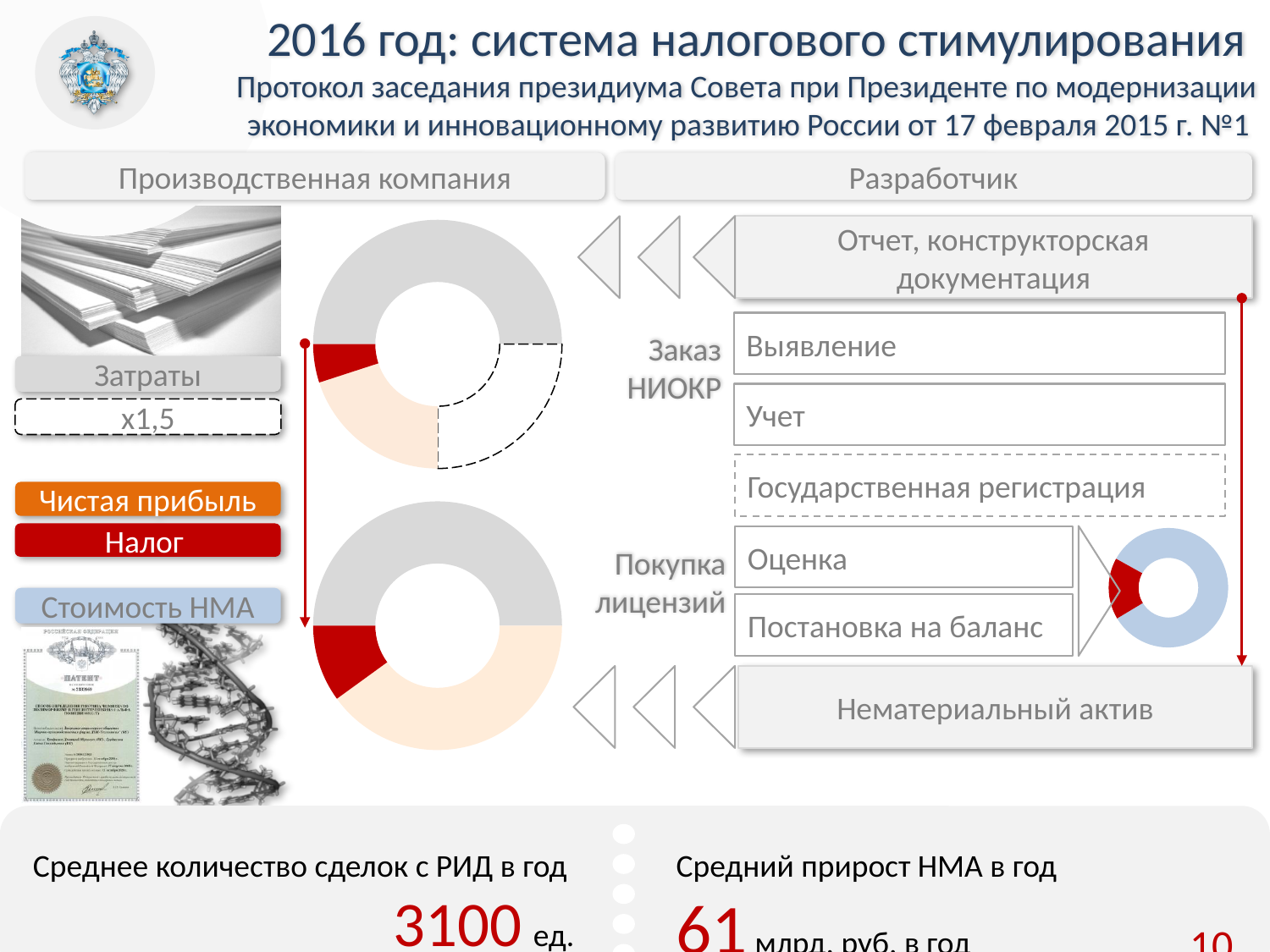
In the lower donut chart, which colour slice is the largest? grey In the lower donut chart, which colour slice is the smallest? red In the small donut chart on the right, which colour slice is the largest? light blue Which colour is used for the label 'Чистая прибыль' on the slide? orange In the lower donut chart, which slice is larger: the red slice or the light peach slice? the light peach slice In the upper donut chart, which filled colour slice is the smallest? red In the upper donut chart, which colour slice is the largest? grey How many donut charts are shown on the slide? 3 What kind of charts are the two large charts in the middle of the slide? pie (donut) charts Which colour is used for the label 'Налог' on the slide? red